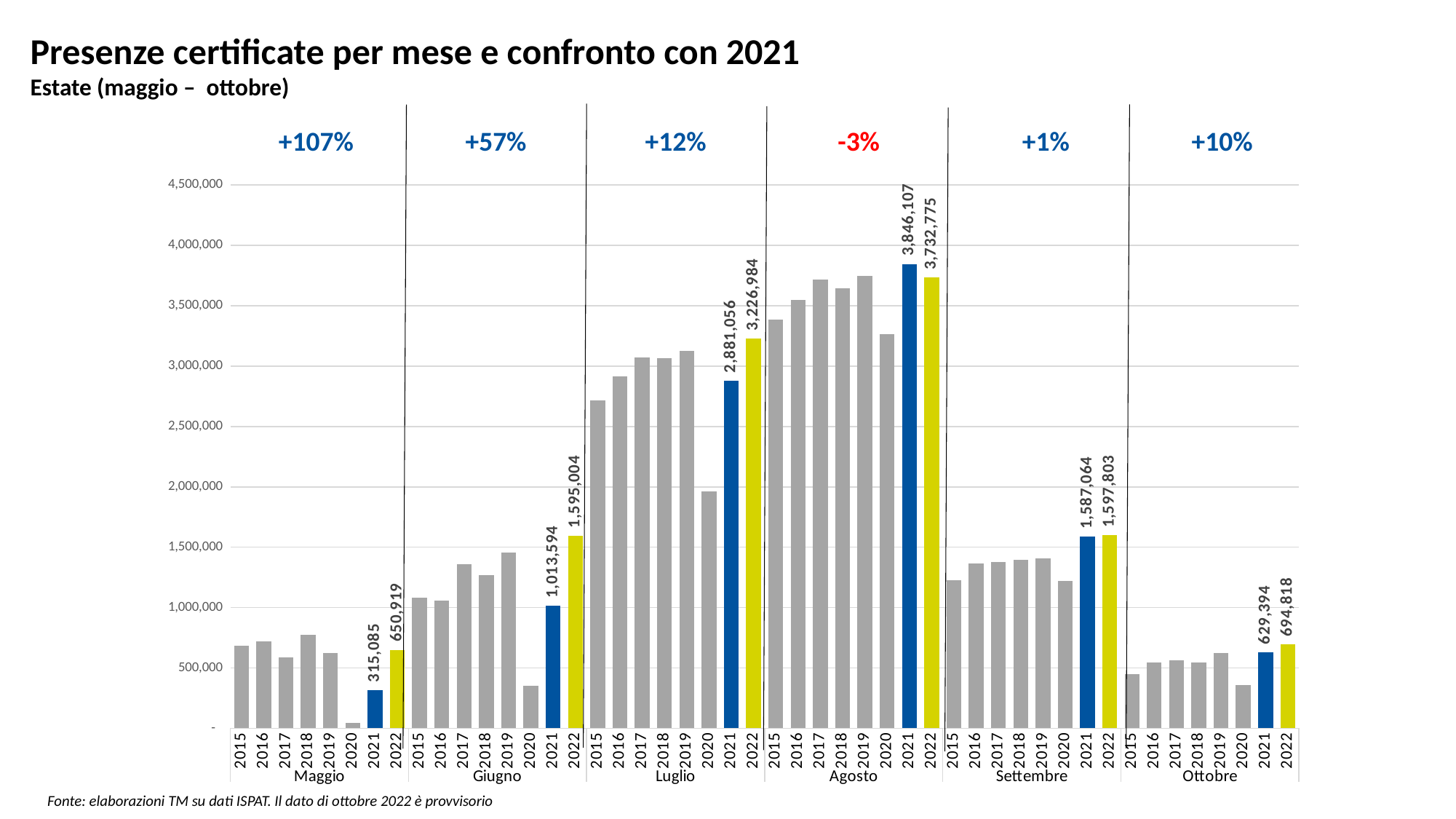
Is the value for Maggio 2020 greater or less than 500,000? less Which month shows a negative percentage change compared with 2021? Agosto (-3%) What is the value for Luglio 2021? 2,881,056 Which labelled bar has the lowest value on the chart? Maggio 2021 (315,085) How many months are shown on the chart? 6 What is the difference between the Giugno 2022 and Giugno 2021 values? 581,410 What is the value for Ottobre 2021? 629,394 What is the value for Agosto 2022? 3,732,775 What is the difference between the Agosto 2021 and Agosto 2022 values? 113,332 What is the value for Maggio 2022? 650,919 Which labelled bar has the highest value on the chart? Agosto 2021 (3,846,107) Which is larger, the Luglio 2021 value or the Luglio 2022 value? Luglio 2022